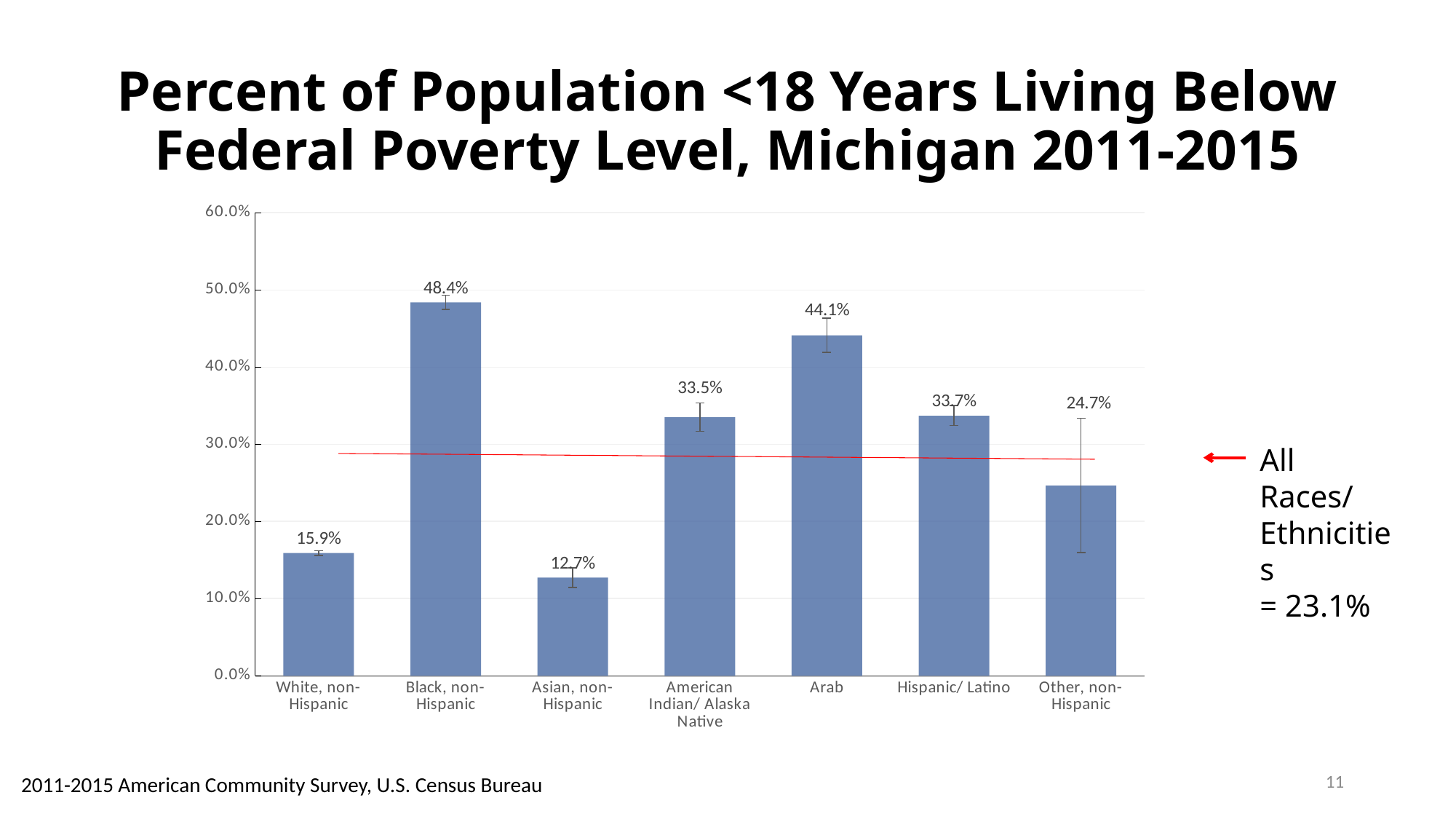
What is the value for Arab? 44.1% How many categories are shown on the x axis? 7 Is the value for American Indian/ Alaska Native greater or less than 30.0%? greater What is the value for Other, non-Hispanic? 24.7% What is the value for Black, non-Hispanic? 48.4% Which is larger, the value for Arab or the value for Hispanic/ Latino? Arab Which category has the lowest value? Asian, non-Hispanic What kind of chart is this? bar chart What value is given for All Races/Ethnicities in the annotation next to the chart? 23.1% What is the value for Asian, non-Hispanic? 12.7% Which category has the highest value? Black, non-Hispanic What is the difference between the values for Black, non-Hispanic and White, non-Hispanic? 32.5%